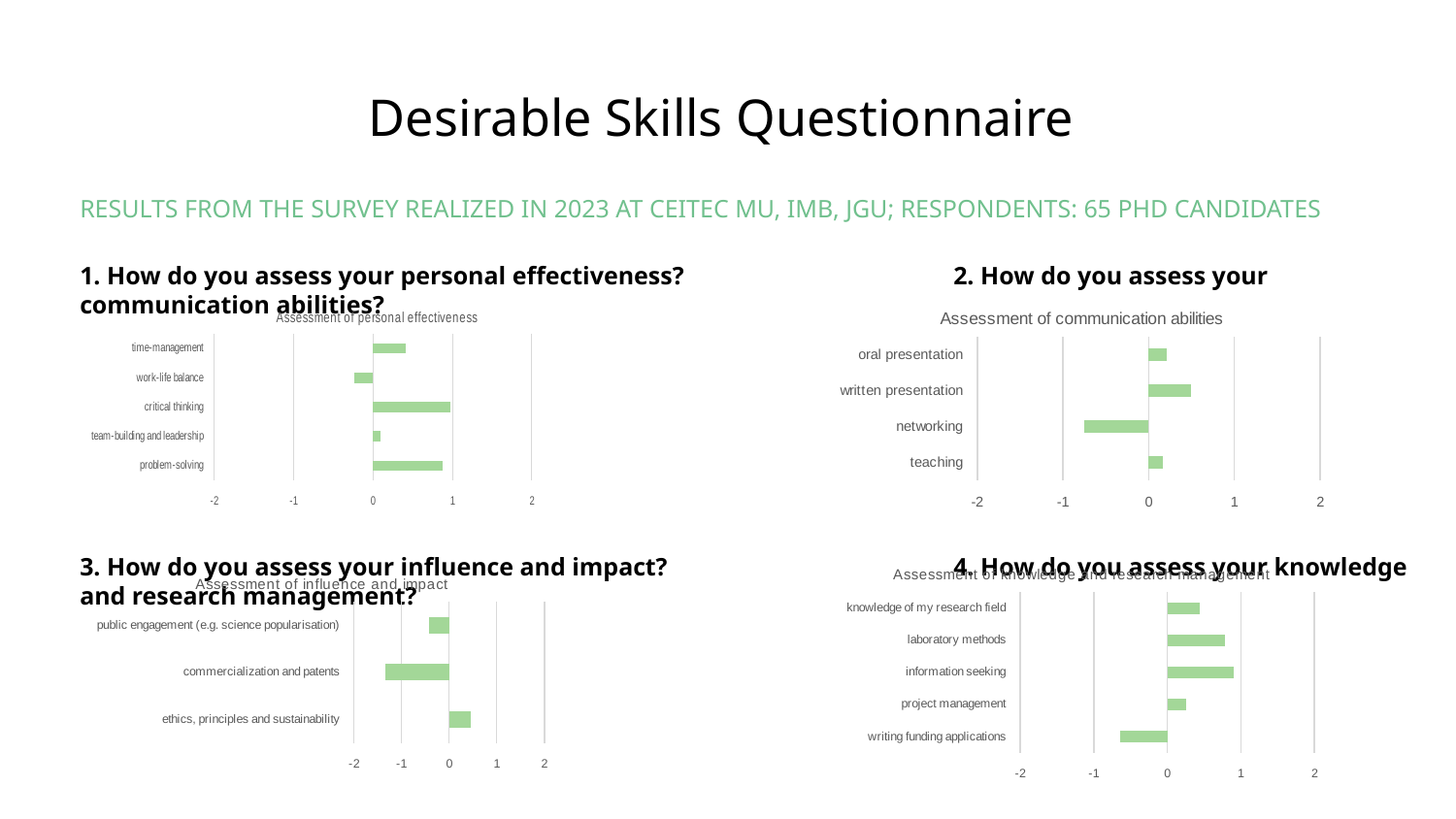
In the 'Assessment of influence and impact' chart, which category has the lowest value? commercialization and patents In the 'Assessment of communication abilities' chart, which category has the lowest value? networking In the 'Assessment of influence and impact' chart, is the value for commercialization and patents greater or less than -1? less In the 'Assessment of personal effectiveness' chart, which is larger: the value for critical thinking or the value for team-building and leadership? critical thinking In the 'Assessment of communication abilities' chart, which category has the highest value? written presentation In the 'Assessment of communication abilities' chart, is the value for networking greater or less than 0? less In the 'Assessment of influence and impact' chart, which category has the highest value? ethics, principles and sustainability How many categories are shown in the 'Assessment of knowledge and research management' chart? 5 In the 'Assessment of knowledge and research management' chart, which is larger: the value for laboratory methods or the value for project management? laboratory methods In the 'Assessment of knowledge and research management' chart, which category has the lowest value? writing funding applications What kind of chart is the 'Assessment of influence and impact' chart? bar chart In the 'Assessment of personal effectiveness' chart, which category has the lowest value? work-life balance